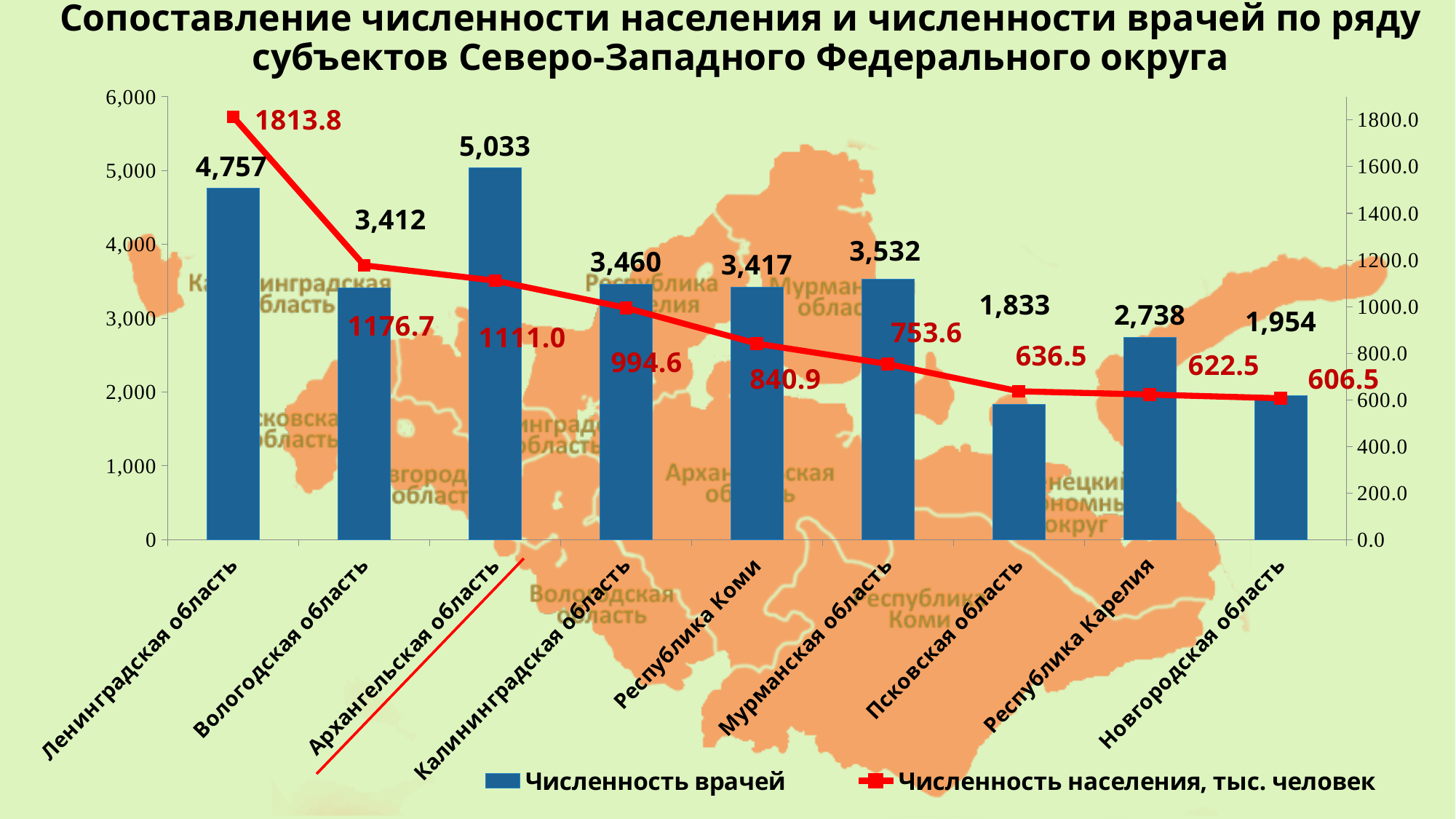
Does the population line rise or fall from left to right across the regions? fall How many regions are shown on the x axis? 9 Which has more doctors, Вологодская область or Республика Коми? Республика Коми What is the difference in the number of doctors between Архангельская область and Ленинградская область? 276 What is the population in thousands for Мурманская область? 753.6 Which region has the lowest number of doctors? Псковская область What is the number of doctors for Республика Карелия? 2,738 How many series does the legend list? 2 What is the population in thousands (Численность населения, тыс. человек) for Ленинградская область? 1813.8 Which region has the highest number of doctors? Архангельская область Which region has the lowest population in thousands? Новгородская область What is the number of doctors (Численность врачей) for Архангельская область? 5,033